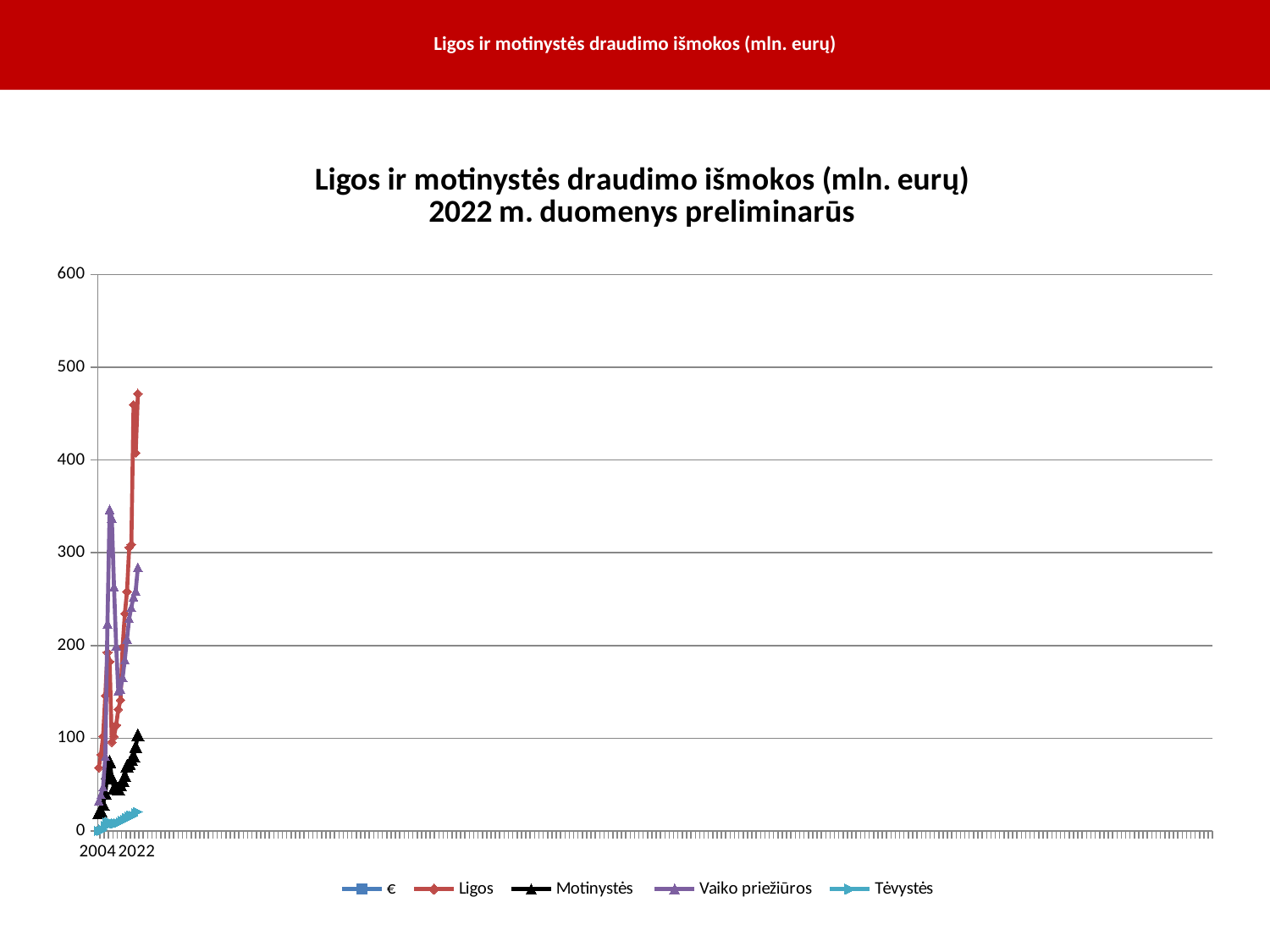
Is the highest value of the Ligos series greater or less than 400? greater How many series does the legend list? 5 Which series reaches the highest value on the chart? Ligos Is the highest value of the Tėvystės series greater or less than 100? less What is the maximum value shown on the vertical axis? 600 What is the second line of the chart title? 2022 m. duomenys preliminarūs Is the highest value of the Vaiko priežiūros series greater or less than 400? less Which series reaches a higher peak, Ligos or Vaiko priežiūros? Ligos Which series reaches a higher peak, Motinystės or Tėvystės? Motinystės What kind of chart is shown on the slide? line chart Which series stays lowest on the chart? Tėvystės